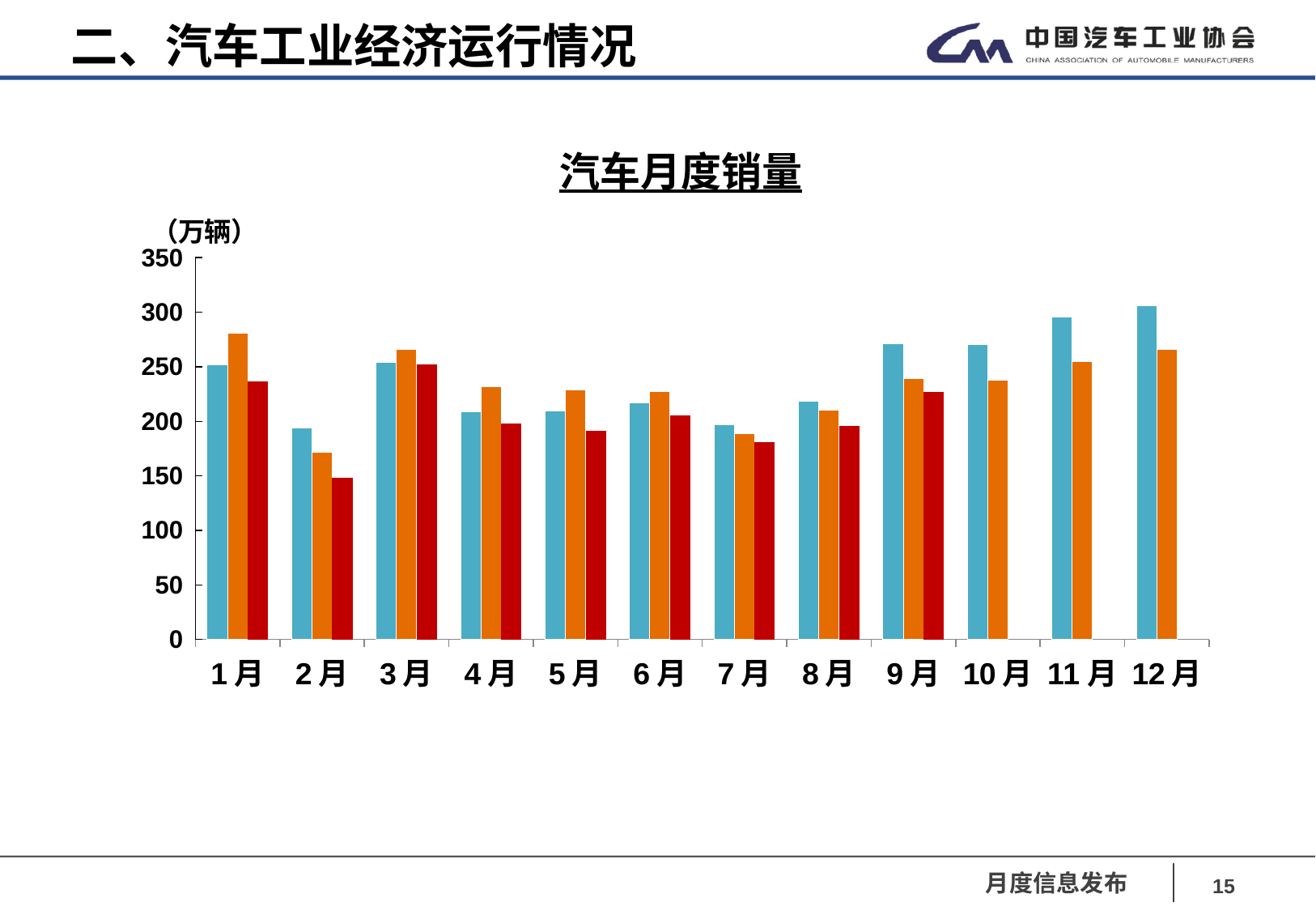
How many months are shown on the x axis of the chart? 12 Is the value of the blue bar for 9月 greater or less than 250? greater Is the value of the blue bar for 2月 greater or less than 200? less What unit is shown on the chart's y axis? 万辆 What kind of chart is shown on the slide? bar chart For 12月, which bar is taller, the blue bar or the orange bar? the blue bar What is the title of the chart? 汽车月度销量 For 1月, which bar is taller, the blue bar or the orange bar? the orange bar Is the value of the red bar for 7月 greater or less than 200? less How many bars are plotted for 1月? 3 Among the red bars, which month has the lowest value? 2月